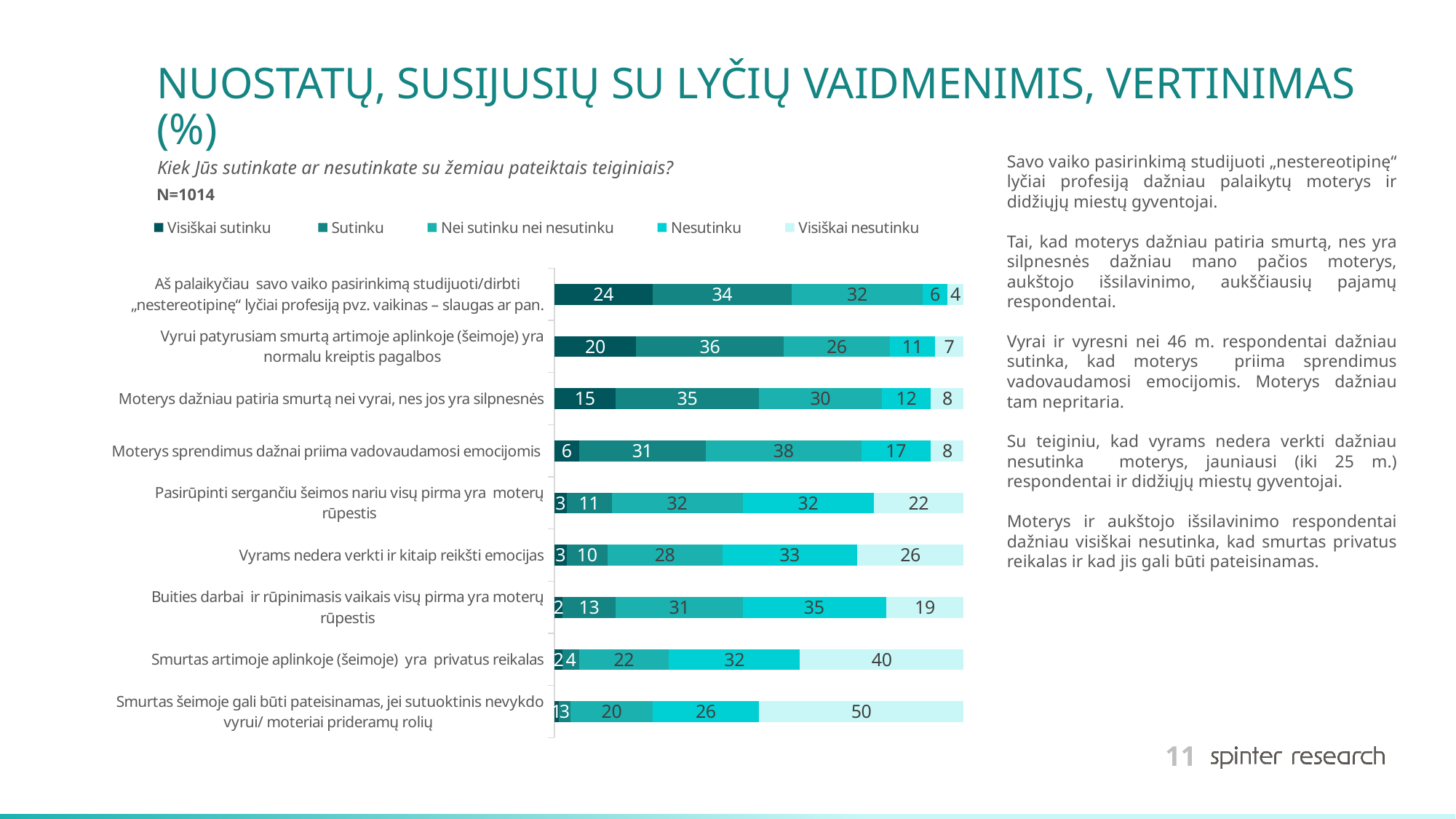
How many statements are shown in the chart? 9 What percentage of respondents answered "Visiškai sutinku" to the statement "Aš palaikyčiau savo vaiko pasirinkimą studijuoti/dirbti „nestereotipinę“ lyčiai profesiją"? 24 How many series does the legend list? 5 What is the "Visiškai nesutinku" value for the statement "Smurtas šeimoje gali būti pateisinamas, jei sutuoktinis nevykdo vyrui/ moteriai prideramų rolių"? 50 Which statement has the lowest "Visiškai nesutinku" value? Aš palaikyčiau savo vaiko pasirinkimą studijuoti/dirbti „nestereotipinę“ lyčiai profesiją pvz. vaikinas – slaugas ar pan. What kind of chart is shown on the slide? Stacked bar chart Which is larger: the "Nesutinku" value for "Buities darbai ir rūpinimasis vaikais visų pirma yra moterų rūpestis" or for "Moterys dažniau patiria smurtą nei vyrai, nes jos yra silpnesnės"? Buities darbai ir rūpinimasis vaikais visų pirma yra moterų rūpestis What is the "Nei sutinku nei nesutinku" value for "Moterys sprendimus dažnai priima vadovaudamosi emocijomis"? 38 What is the sample size (N) stated on the slide? N=1014 What is the difference between the "Sutinku" values for "Vyrui patyrusiam smurtą artimoje aplinkoje (šeimoje) yra normalu kreiptis pagalbos" and "Vyrams nedera verkti ir kitaip reikšti emocijas"? 26 Which statement has the highest "Visiškai nesutinku" value? Smurtas šeimoje gali būti pateisinamas, jei sutuoktinis nevykdo vyrui/ moteriai prideramų rolių What is the combined "Visiškai sutinku" and "Sutinku" value for "Moterys dažniau patiria smurtą nei vyrai, nes jos yra silpnesnės"? 50